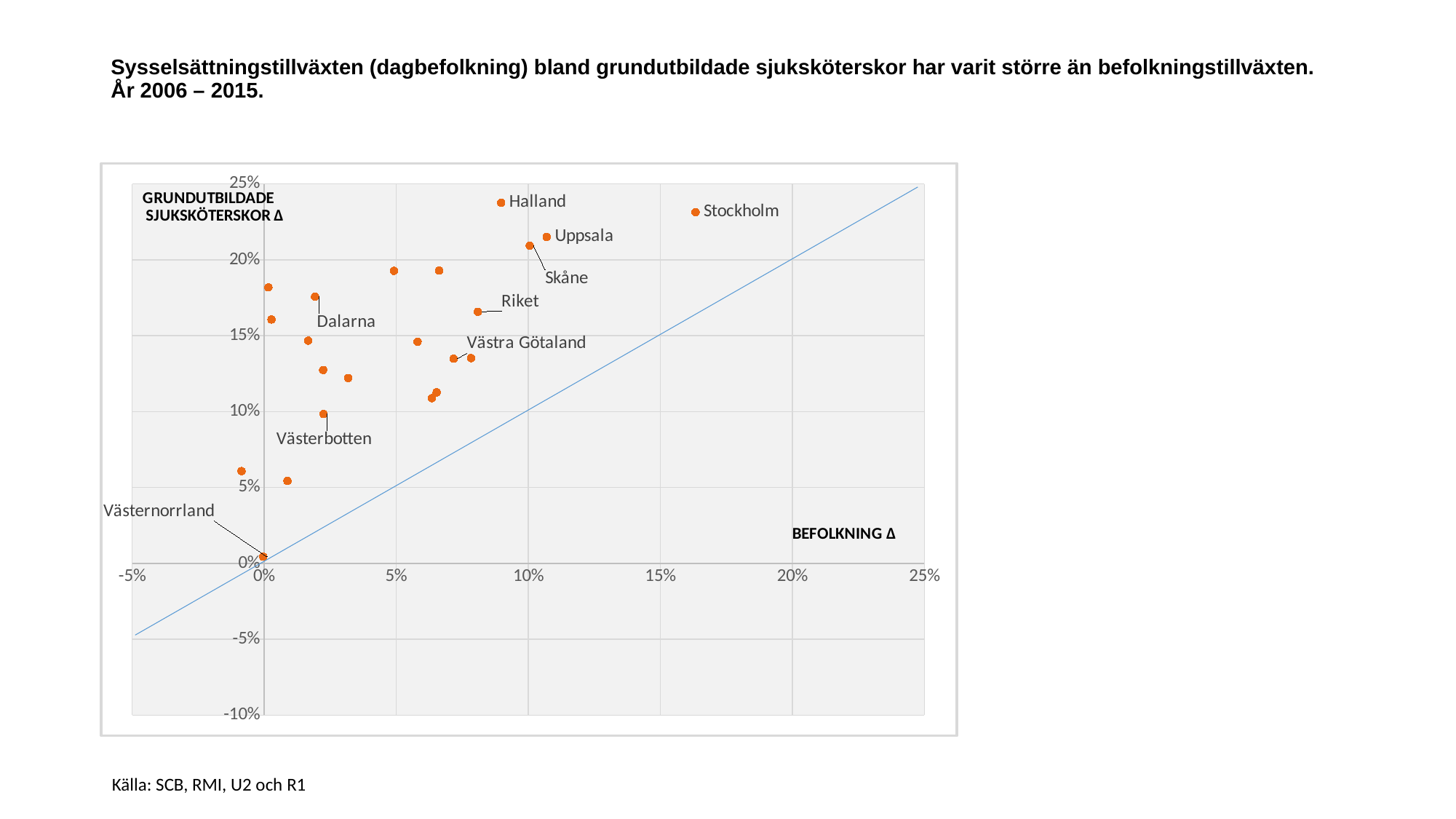
Is the vertical-axis value for Västernorrland greater or less than 5%? less Which labelled point has the lowest value on the vertical axis (GRUNDUTBILDADE SJUKSKÖTERSKOR Δ)? Västernorrland Which has the larger vertical-axis value, Halland or Riket? Halland Is the vertical-axis value for Halland greater or less than 20%? greater Which has the larger horizontal-axis value (BEFOLKNING Δ), Stockholm or Halland? Stockholm Which labelled point has the highest value on the horizontal axis (BEFOLKNING Δ)? Stockholm What kind of chart is shown on the slide? scatter chart Is the vertical-axis value for Västra Götaland greater or less than 15%? less Which labelled point has the highest value on the vertical axis (GRUNDUTBILDADE SJUKSKÖTERSKOR Δ)? Halland What is the label of the horizontal axis of the chart? BEFOLKNING Δ